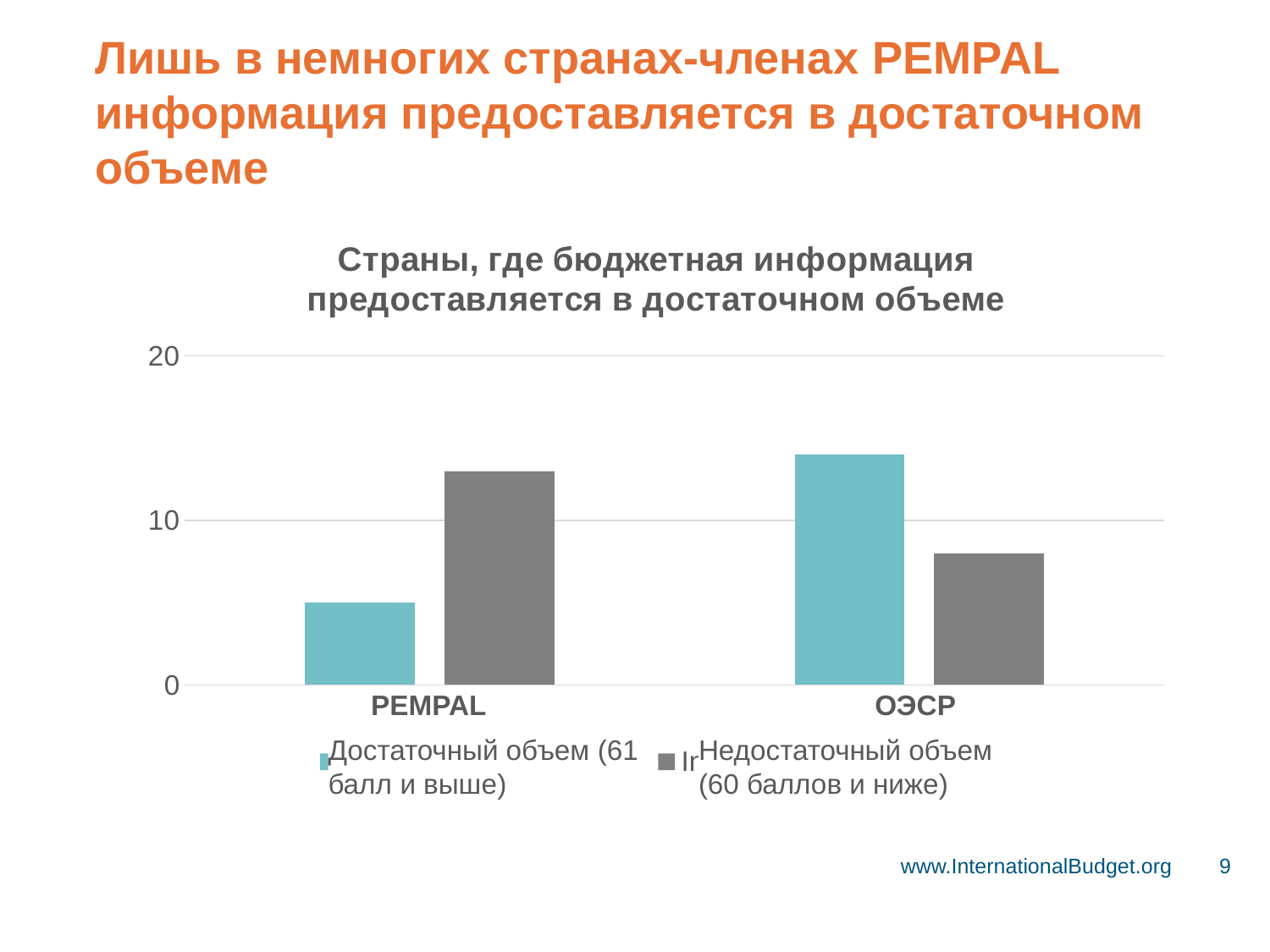
What colour are the bars for the 'Недостаточный объем (60 баллов и ниже)' series? Grey For PEMPAL, which series has the larger value: 'Достаточный объем (61 балл и выше)' or 'Недостаточный объем (60 баллов и ниже)'? Недостаточный объем (60 баллов и ниже) What kind of chart is shown on the slide? Bar chart How many series does the chart's legend list? 2 For ОЭСР, which series has the larger value: 'Достаточный объем (61 балл и выше)' or 'Недостаточный объем (60 баллов и ниже)'? Достаточный объем (61 балл и выше) How many categories are shown on the x axis of the chart? 2 What is the title of the chart? Страны, где бюджетная информация предоставляется в достаточном объеме Is the value for 'Недостаточный объем (60 баллов и ниже)' for ОЭСР greater or less than 10? less Which category has the higher value for 'Достаточный объем (61 балл и выше)': PEMPAL or ОЭСР? ОЭСР Is the value for 'Достаточный объем (61 балл и выше)' for ОЭСР greater or less than 10? greater Is the value for 'Достаточный объем (61 балл и выше)' for PEMPAL greater or less than 10? less